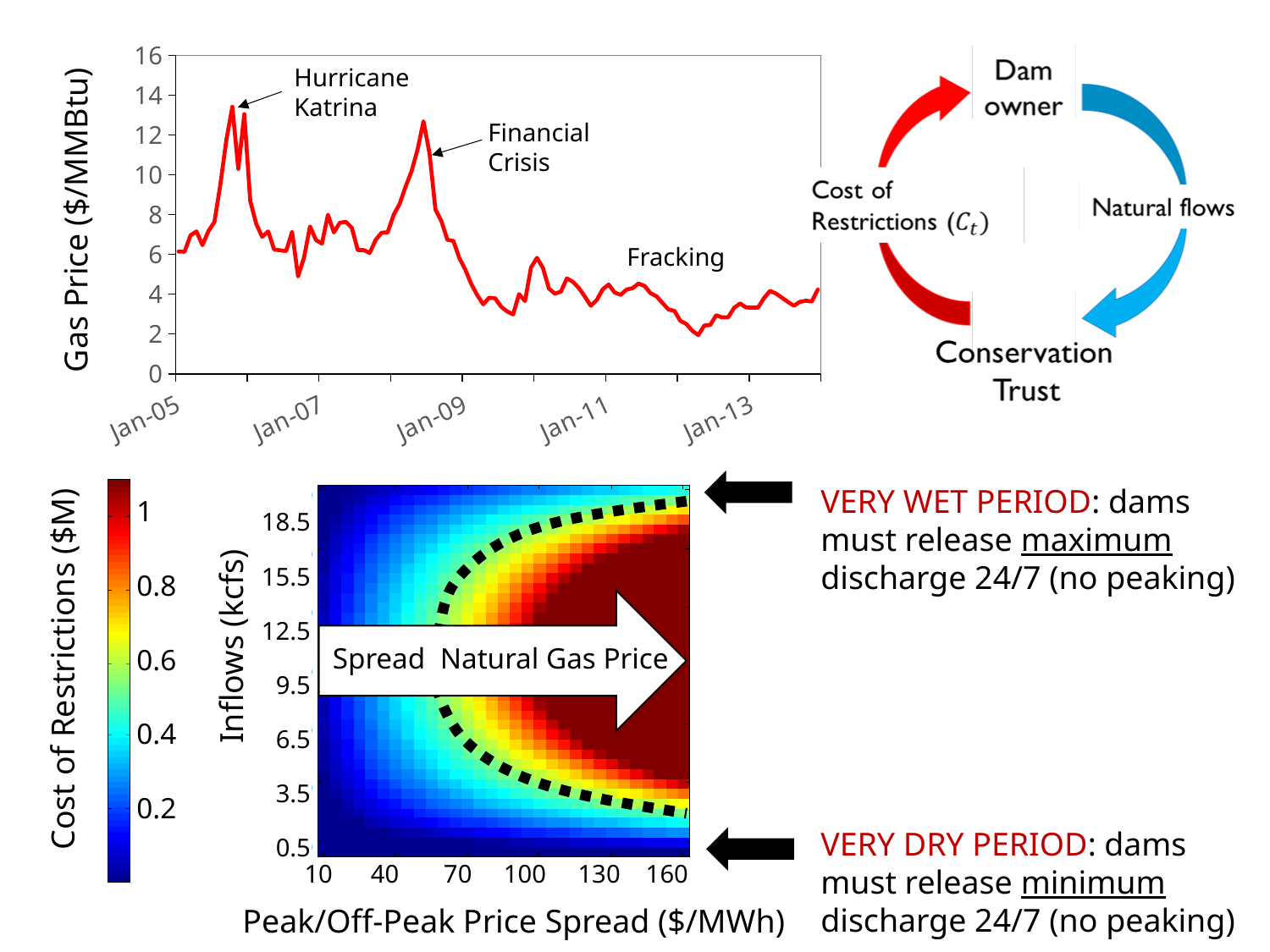
On the top-left gas price chart, is the gas price around Jan-13 greater or less than 4 $/MMBtu? less On the top-left chart, what is the label of the y axis? Gas Price ($/MMBtu) What kind of chart is the top-left chart showing gas price over time? line chart On the top-left gas price chart, does the gas price generally rise or fall between Jan-09 and Jan-13? fall On the top-left gas price chart, which peak is higher: Hurricane Katrina or Financial Crisis? Hurricane Katrina On the top-left gas price chart, what is the highest value shown on the y axis? 16 On the top-left gas price chart, is the peak labelled Hurricane Katrina greater or less than 12 $/MMBtu? greater What kind of chart is the bottom chart of inflows versus peak/off-peak price spread? heatmap On the bottom heatmap, what is the label of the x axis? Peak/Off-Peak Price Spread ($/MWh) On the top-left gas price chart, which event is annotated at the highest peak? Hurricane Katrina On the bottom heatmap, what is the highest value labelled on the Cost of Restrictions colour bar? 1 On the top-left gas price chart, is the peak labelled Financial Crisis greater or less than 10 $/MMBtu? greater